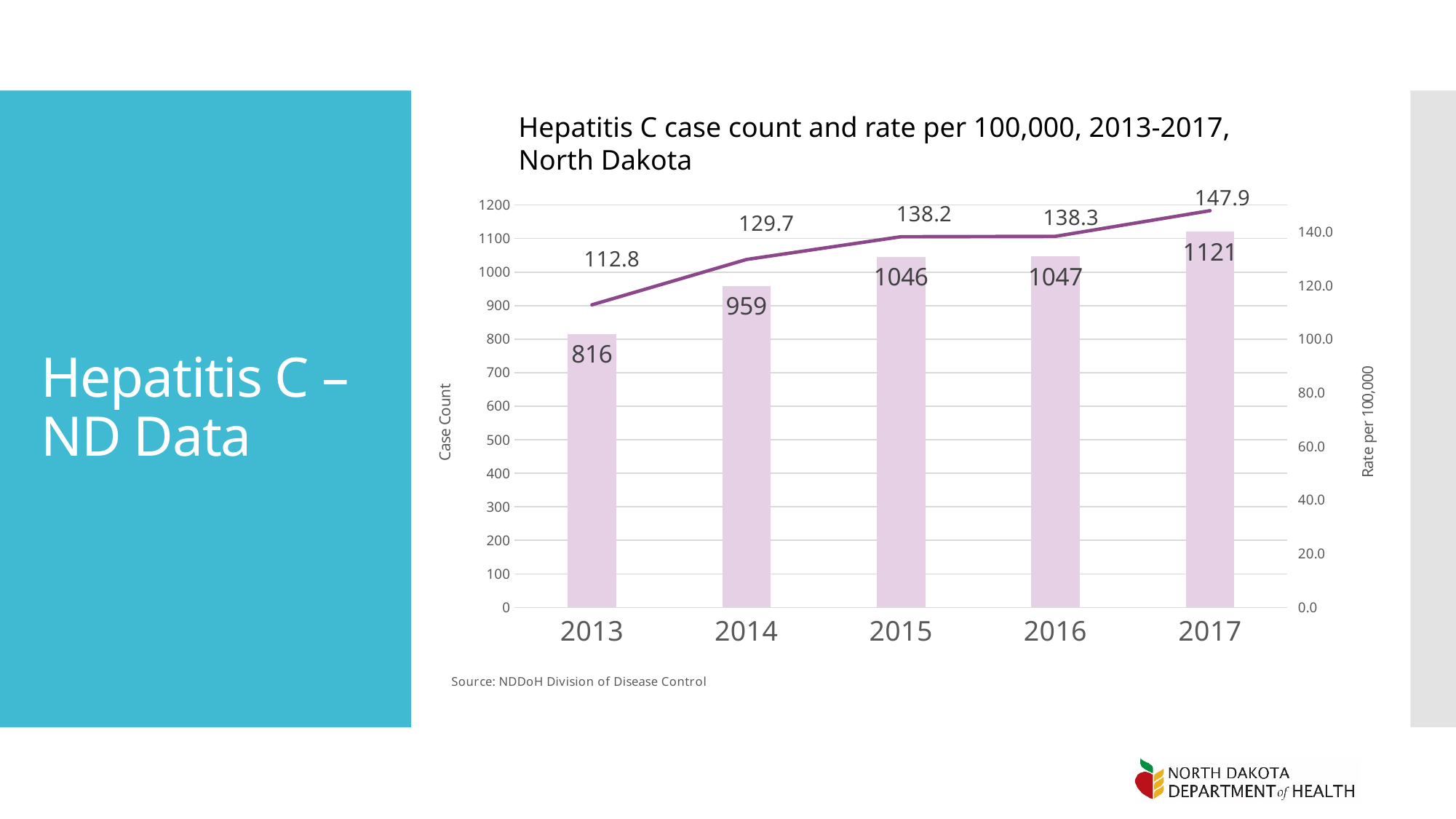
How many more Hepatitis C cases were there in 2017 than in 2013? 305 What was the Hepatitis C rate per 100,000 in 2017? 147.9 What was the Hepatitis C case count in 2015? 1046 What is the title of the chart? Hepatitis C case count and rate per 100,000, 2013-2017, North Dakota What is the overall trend of the Hepatitis C rate per 100,000 from 2013 to 2017? Rising What was the Hepatitis C rate per 100,000 in 2014? 129.7 What was the Hepatitis C case count in North Dakota in 2013? 816 Which year had the highest Hepatitis C case count? 2017 How many years are shown on the x axis of the chart? 5 Which year had the lowest Hepatitis C rate per 100,000? 2013 Which year had a higher case count, 2014 or 2016? 2016 By how much did the rate per 100,000 increase from 2013 to 2014? 16.9